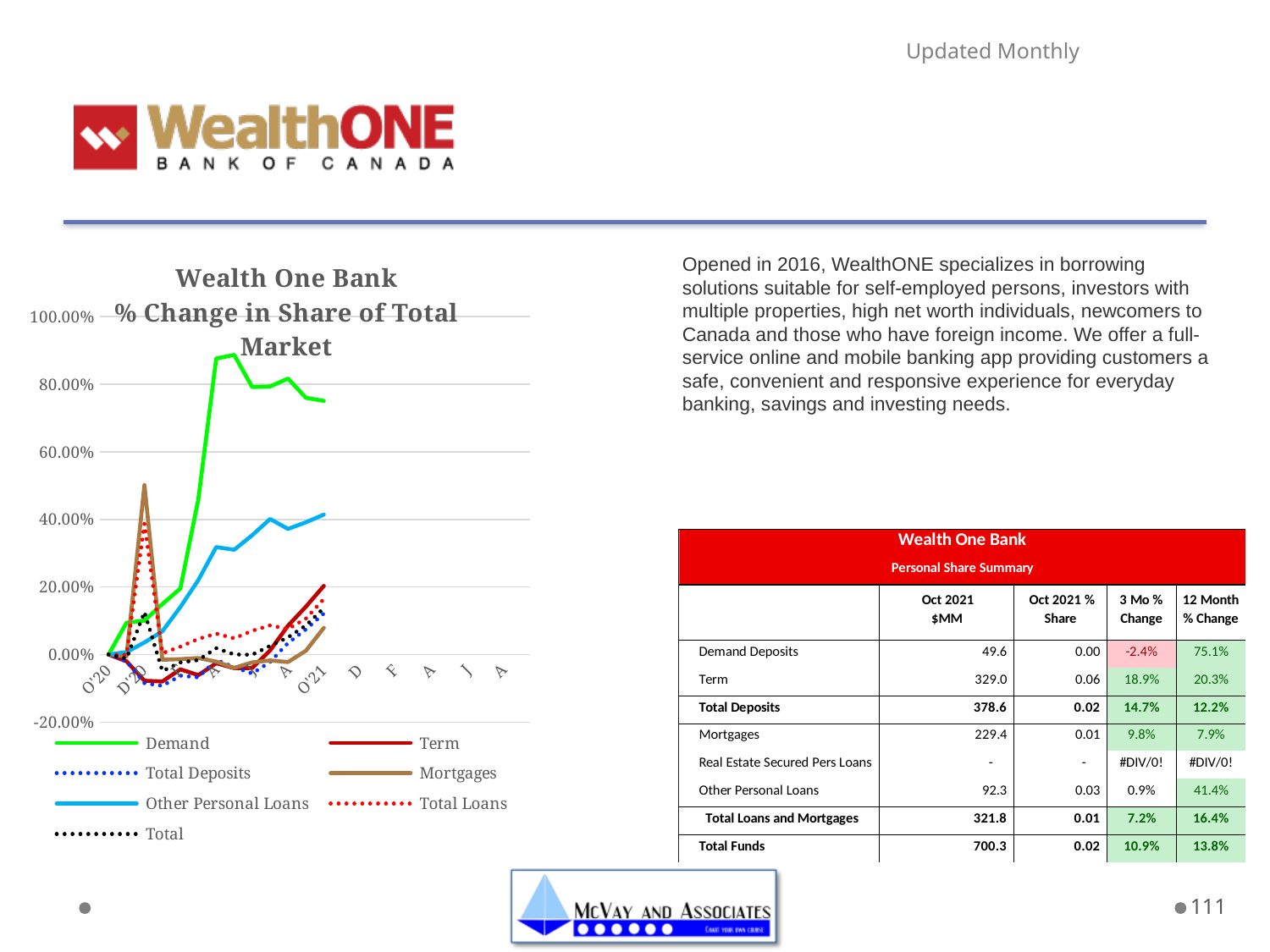
How many series does the chart legend list? 7 Is the peak value of the Demand series greater or less than 80.00%? greater At O'21, which series has the larger value: Demand or Other Personal Loans? Demand What kind of chart is shown on the slide? line chart What is the highest value shown on the chart's vertical axis? 100.00% Is the value of the Other Personal Loans series at O'21 greater or less than 20.00%? greater Is the value of the Demand series at O'21 greater or less than 60.00%? greater Which series reaches the highest value on the chart? Demand What is the title of the chart? Wealth One Bank % Change in Share of Total Market Which colour is used for the Demand series in the chart? green